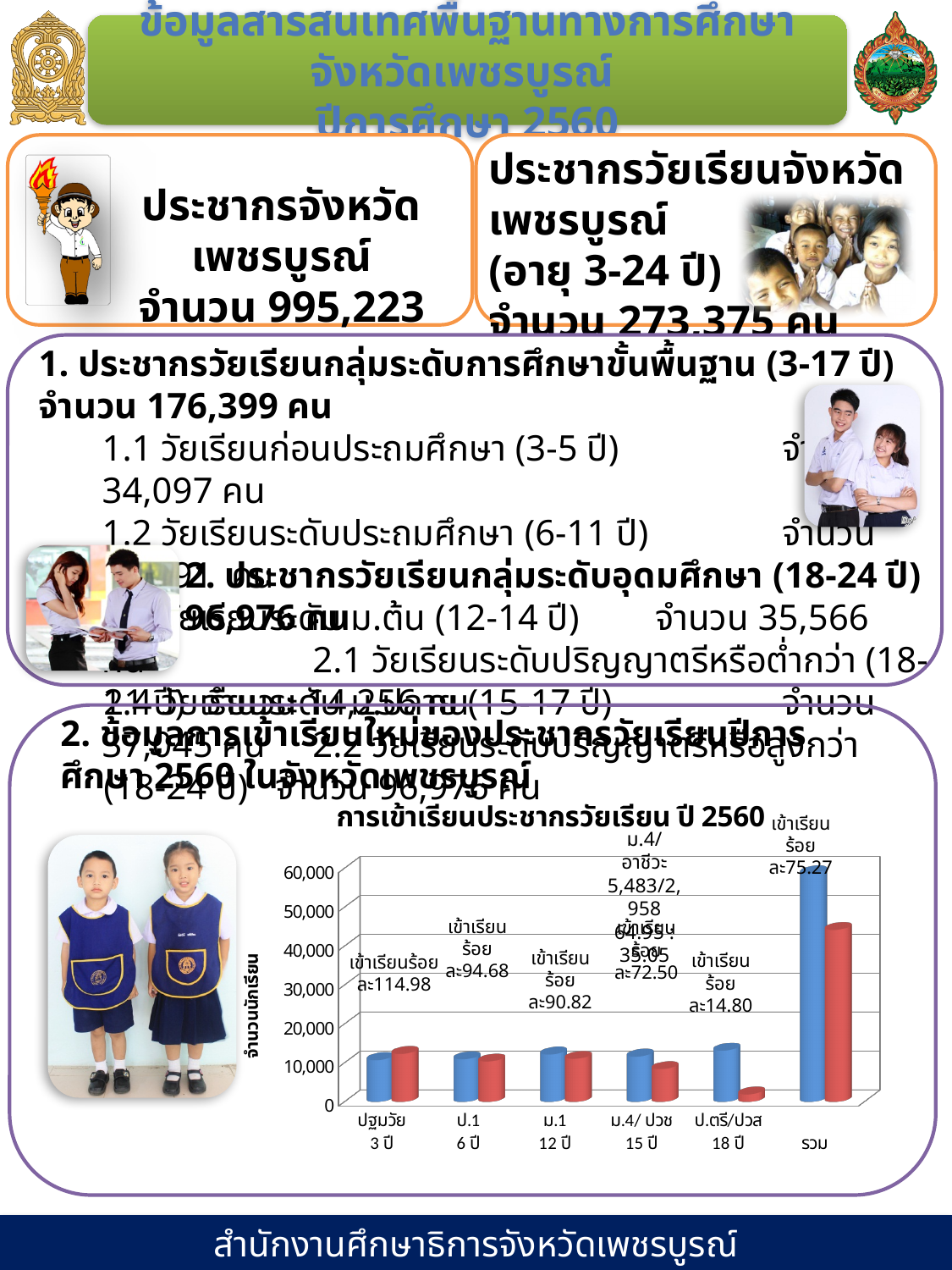
How many categories are shown on the x axis of the chart? 6 What kind of chart is shown on the slide? bar chart Is the blue bar for รวม greater or less than 50,000? greater Which category has the shortest red bar in the chart? ป.ตรี/ปวส 18 ปี What enrolment percentage (ร้อยละ) is labelled for ปฐมวัย 3 ปี? 114.98 What is the label of the vertical axis of the chart? จำนวนนักเรียน What is the title of the chart? การเข้าเรียนประชากรวัยเรียน ปี 2560 For ป.ตรี/ปวส 18 ปี, which bar is larger, the blue one or the red one? blue Is the red bar for รวม greater or less than 40,000? greater What enrolment percentage (ร้อยละ) is labelled for ป.ตรี/ปวส 18 ปี? 14.80 Which category has the tallest bar in the chart? รวม Is the red bar for ป.ตรี/ปวส 18 ปี greater or less than 10,000? less